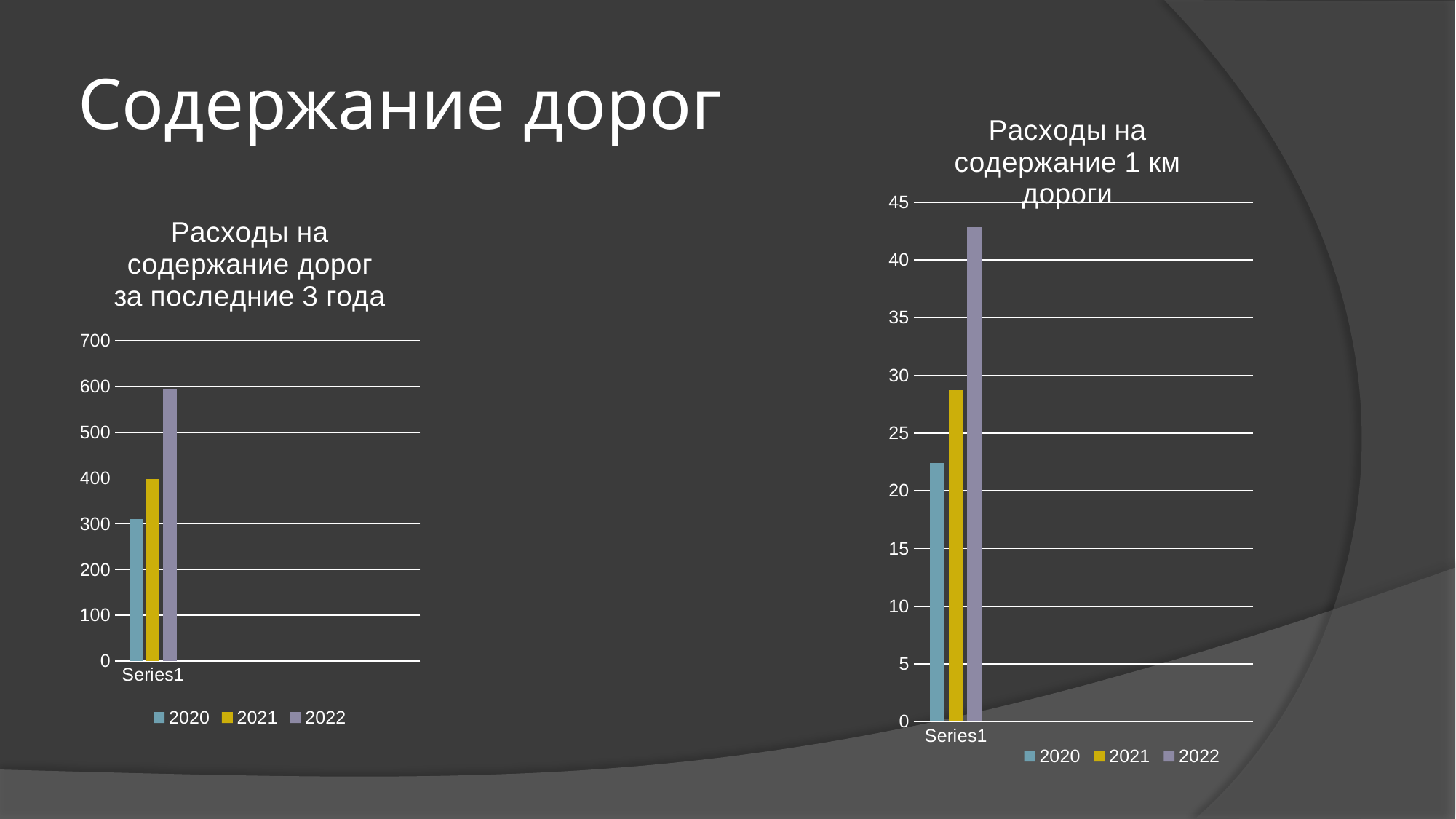
In the right chart 'Расходы на содержание 1 км дороги', which is larger, the value for 2021 or the value for 2020? 2021 What type of chart is the left chart titled 'Расходы на содержание дорог за последние 3 года'? bar chart In the right chart 'Расходы на содержание 1 км дороги', is the value for 2022 greater or less than 40? greater In the right chart 'Расходы на содержание 1 км дороги', which year has the lowest value? 2020 In the right chart 'Расходы на содержание 1 км дороги', is the value for 2021 greater or less than 30? less In the left chart 'Расходы на содержание дорог за последние 3 года', is the value for 2022 greater or less than 500? greater In the right chart 'Расходы на содержание 1 км дороги', which year has the highest value? 2022 In the left chart 'Расходы на содержание дорог за последние 3 года', do the values rise or fall from 2020 to 2022? rise In the left chart 'Расходы на содержание дорог за последние 3 года', which year has the highest bar? 2022 In the left chart 'Расходы на содержание дорог за последние 3 года', which year has the lowest bar? 2020 How many series does the legend of the right chart 'Расходы на содержание 1 км дороги' list? 3